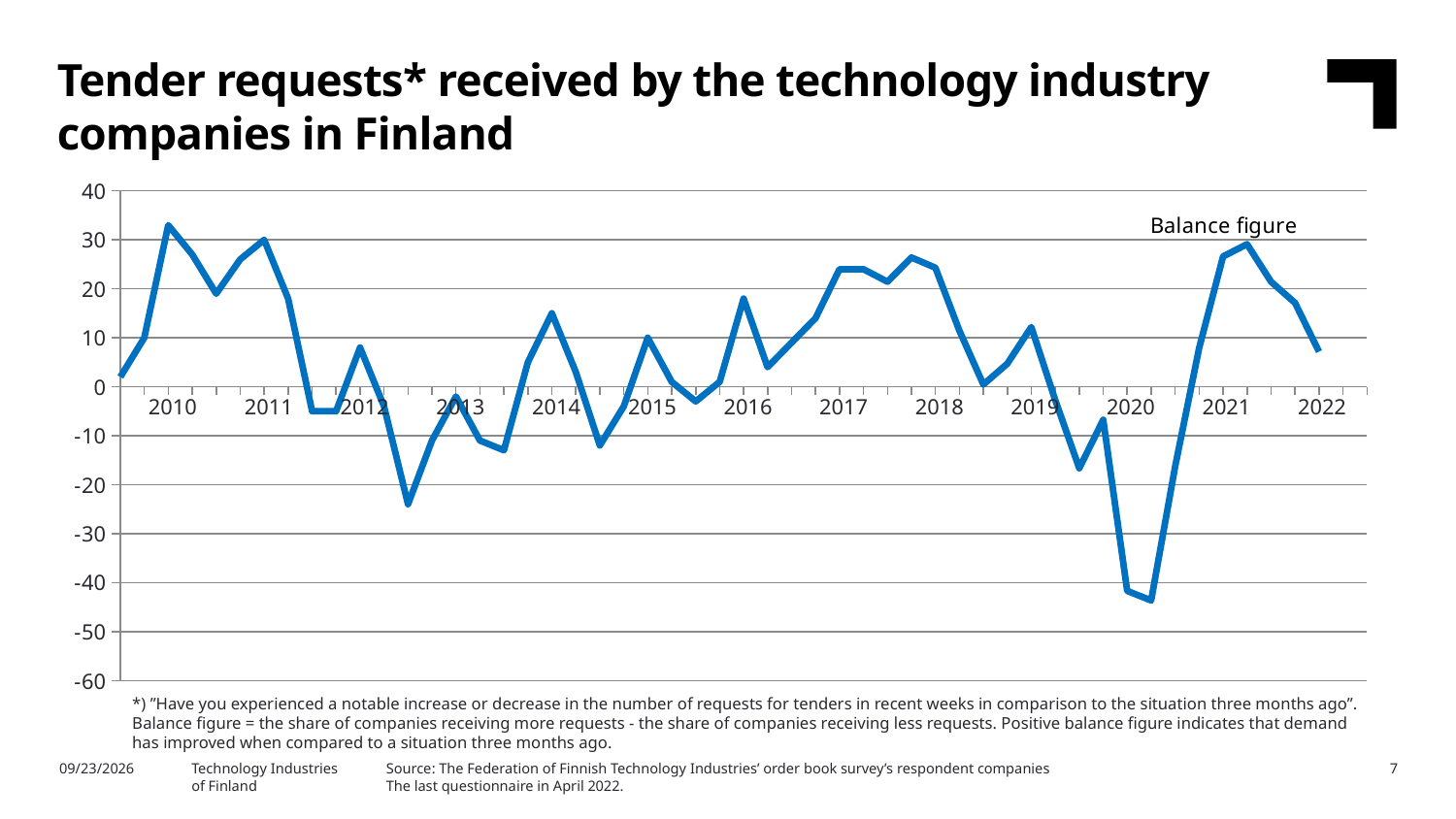
Is the lowest value of the balance figure around 2012 greater or less than -10? less In which year does the balance figure reach its lowest point? 2020 Is the last plotted value of the balance figure in 2022 greater or less than 0? greater How many year labels are shown on the x axis of the chart? 13 Does the balance figure rise or fall from its 2021 peak to the end of the series in 2022? fall What is the title of the chart on the slide? Balance figure What kind of chart is shown on the slide? line chart Is the lowest value of the balance figure in 2020 greater or less than -30? less Which is lower, the dip in the balance figure around 2012 or the dip in 2020? 2020